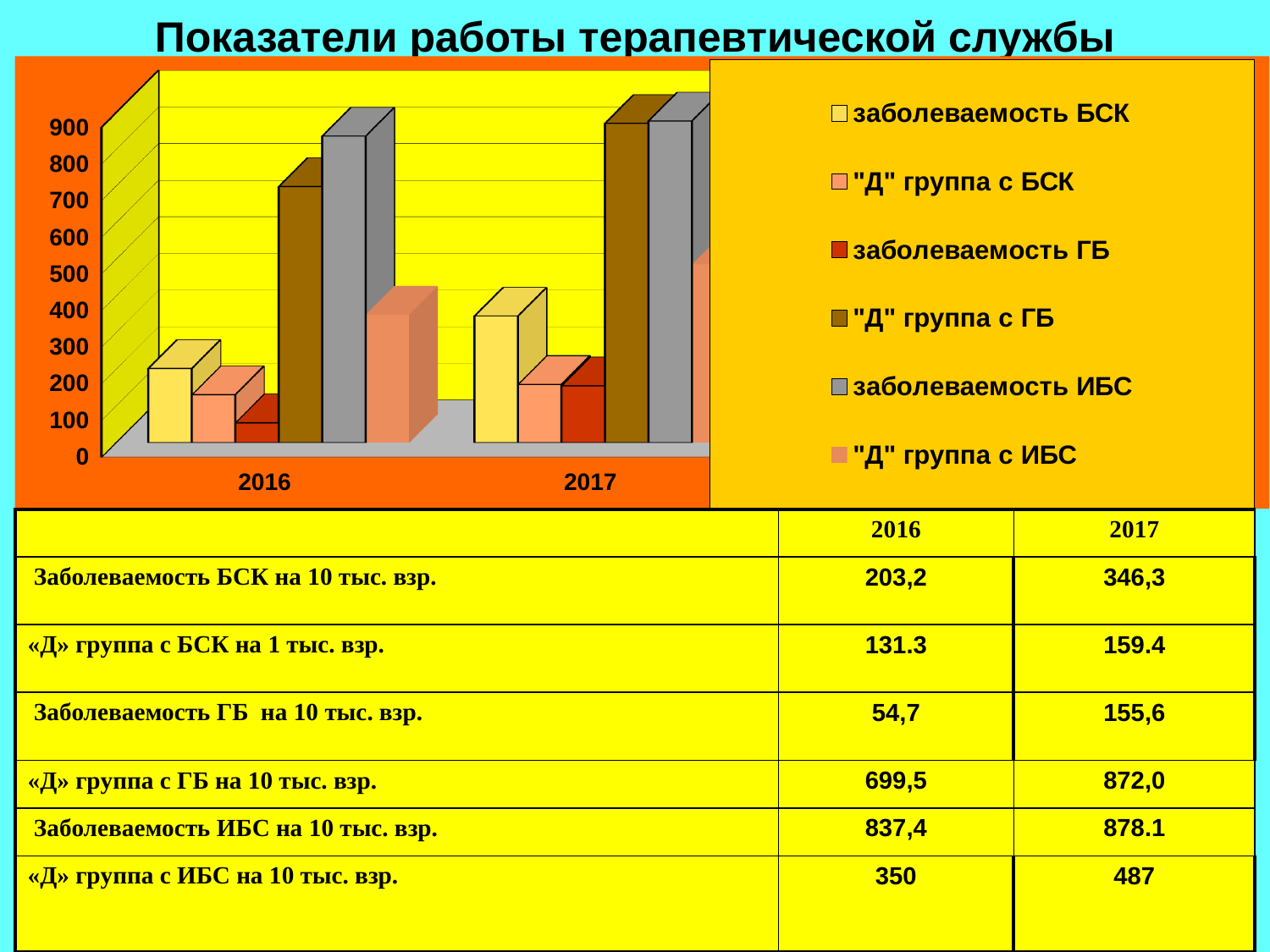
For заболеваемость ГБ, which year has the larger value, 2016 or 2017? 2017 What is the difference between the 2017 and 2016 values of "Д" группа с ИБС? 137 How many series does the chart legend list? 6 What colour represents заболеваемость ИБС in the chart legend? grey How many categories (years) are shown on the x axis of the chart? 2 Which series has the lowest value in 2016? заболеваемость ГБ What is the value of "Д" группа с ГБ for 2017? 872,0 What kind of chart is shown on the slide? bar chart What is the value of заболеваемость БСК for 2016? 203,2 Which series has the highest value in 2016? заболеваемость ИБС Does the value of заболеваемость БСК rise or fall from 2016 to 2017? rises Is the value for заболеваемость ИБС in 2016 greater or less than 800? greater